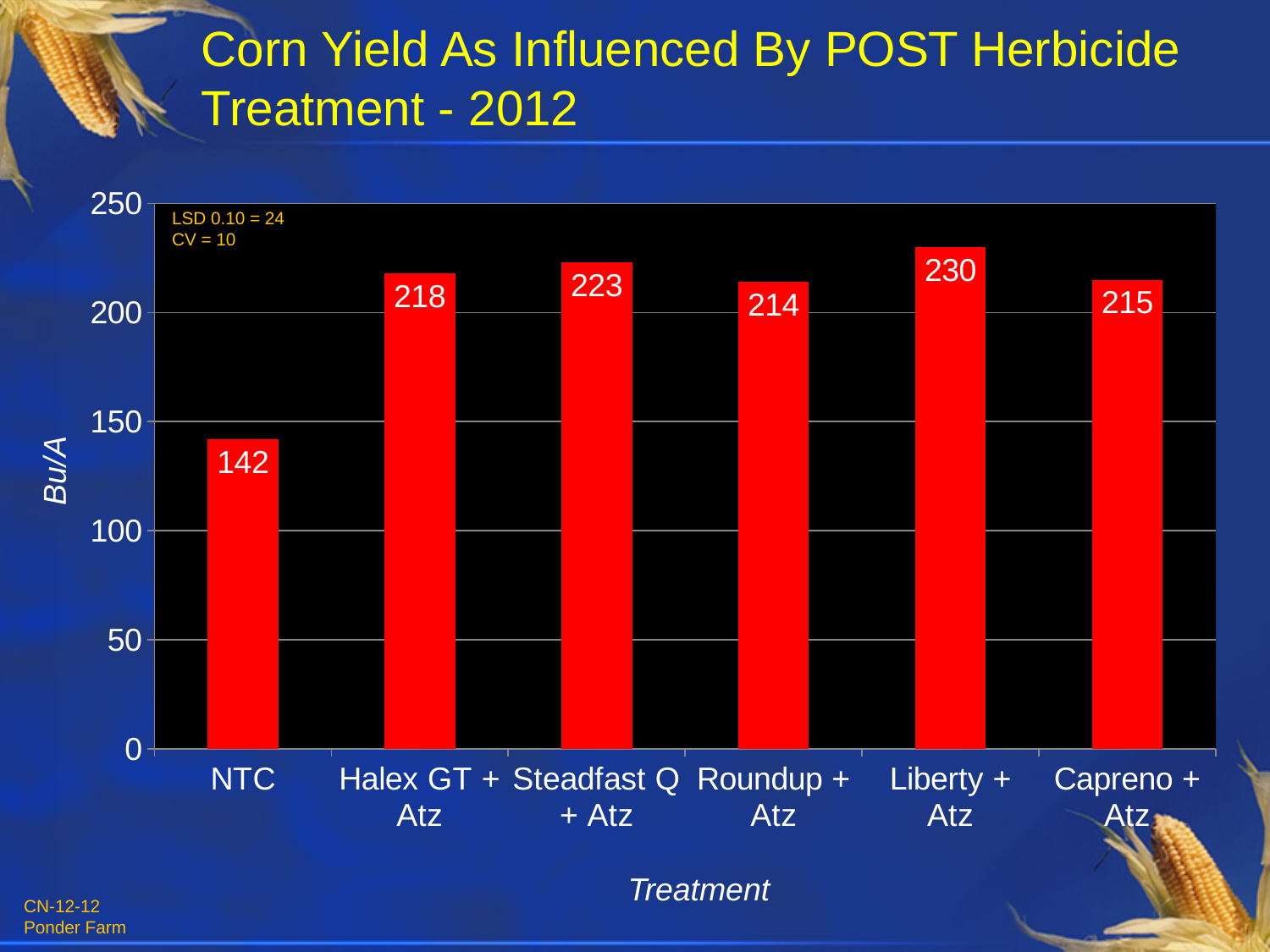
Which has a higher yield, Halex GT + Atz or Capreno + Atz? Halex GT + Atz What kind of chart is shown on the slide? bar chart What is the corn yield for NTC? 142 Which treatment has the highest corn yield? Liberty + Atz What is the corn yield for Roundup + Atz? 214 Which treatment has the lowest corn yield? NTC How many treatments are shown on the chart? 6 What is the difference in yield between Liberty + Atz and NTC? 88 What is the difference in yield between Steadfast Q + Atz and Halex GT + Atz? 5 Is the value for NTC greater or less than 150? less What is the label of the y axis? Bu/A What is the corn yield for Liberty + Atz? 230